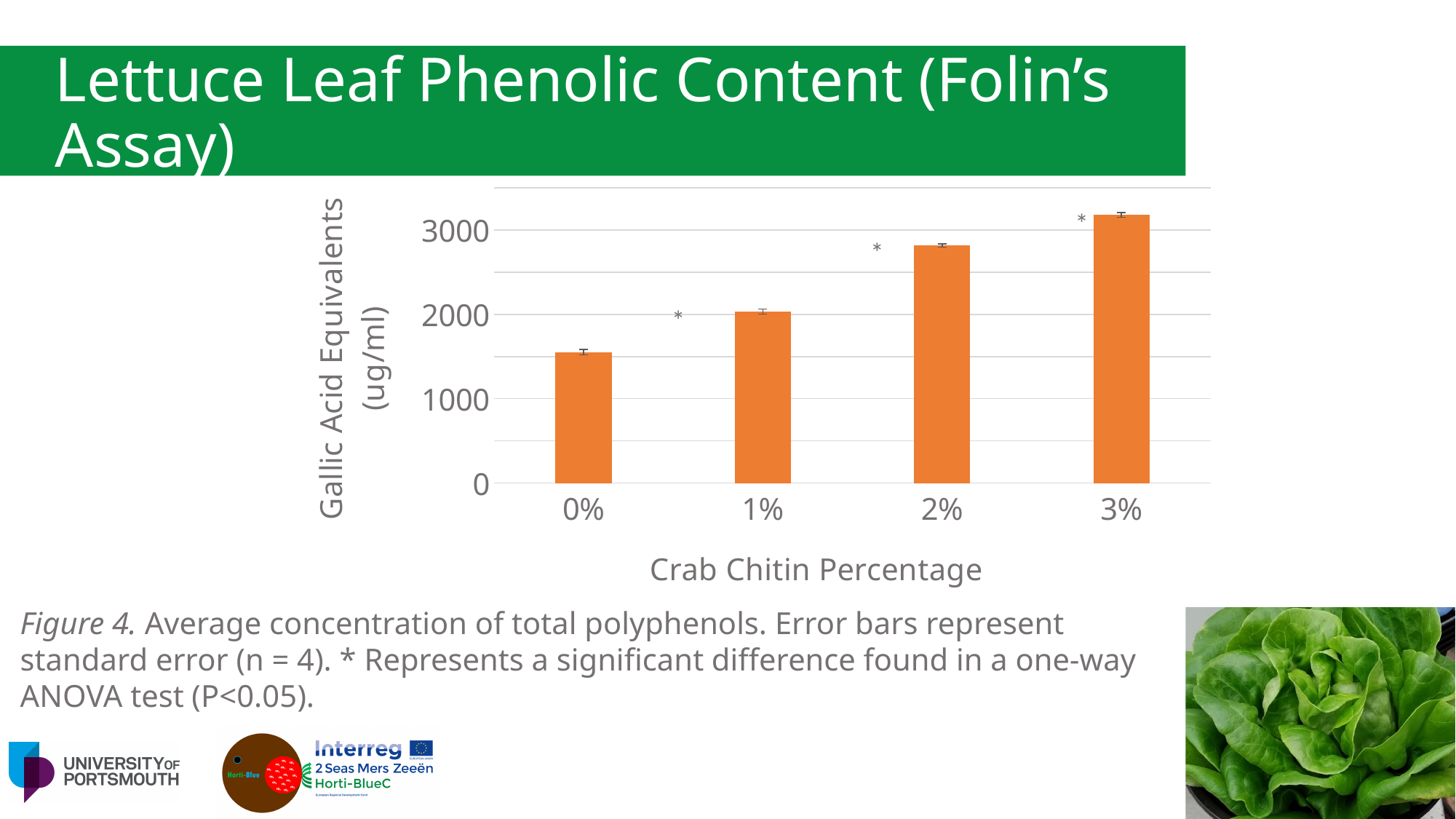
How many crab chitin percentage categories are plotted on the x axis? 4 Do the gallic acid equivalents values rise or fall as the crab chitin percentage increases from 0% to 3%? rise Is the value for 3% crab chitin greater or less than 3000? greater Which crab chitin percentage has the lowest gallic acid equivalents value? 0% Is the value for 2% crab chitin greater or less than 3000? less Which has a larger gallic acid equivalents value, 1% or 2% crab chitin? 2% What is the label of the y axis? Gallic Acid Equivalents (ug/ml) What kind of chart is shown on the slide? bar chart What is the label of the x axis? Crab Chitin Percentage Is the value for 0% crab chitin greater or less than 1000? greater Which crab chitin percentage has the highest gallic acid equivalents value? 3%